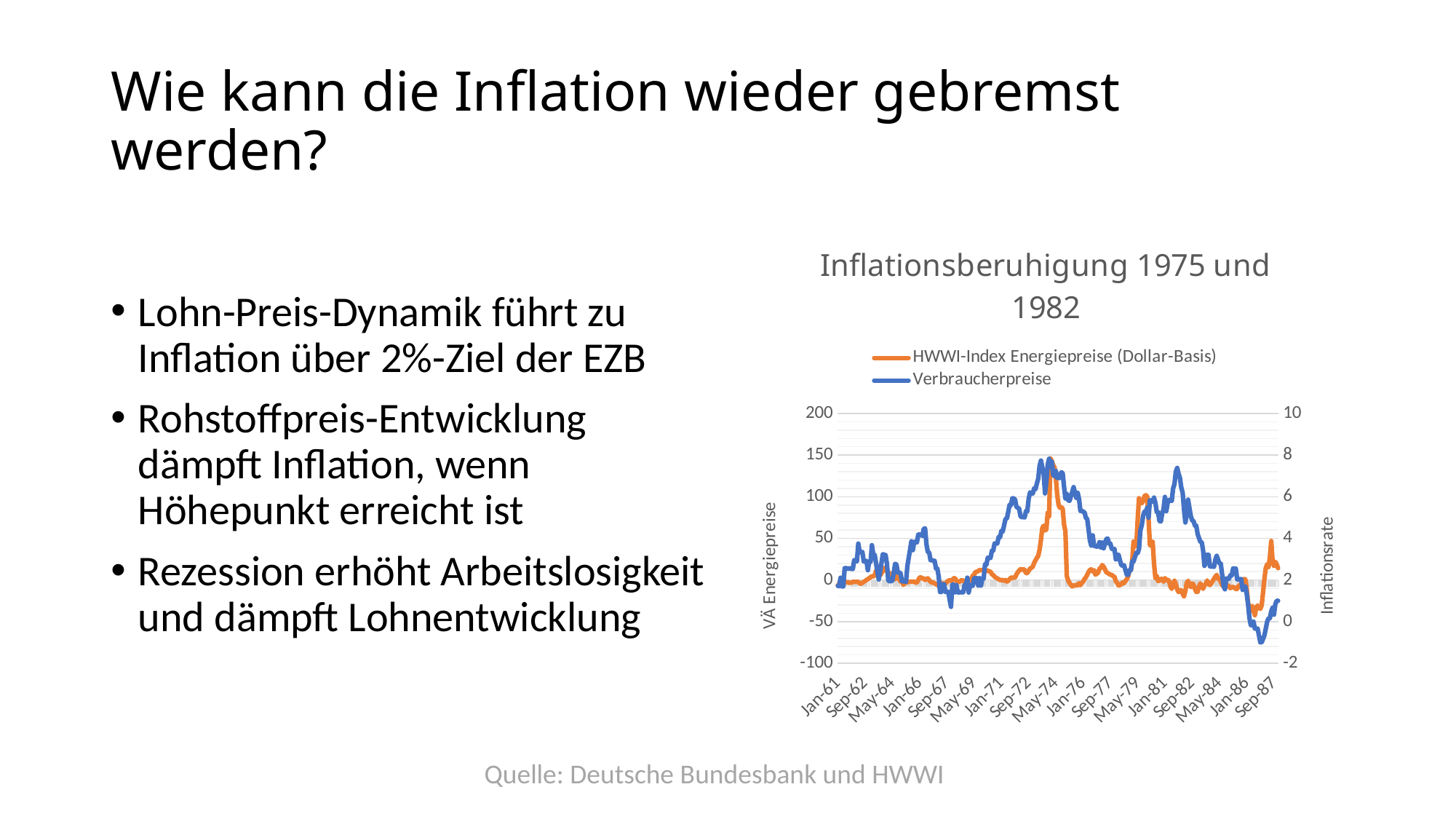
What kind of chart is shown on the slide? Line chart Is the value of the Verbraucherpreise line at its low point around Jan-86 greater or less than 0 on the right axis? less Which series is drawn in orange in the chart? HWWI-Index Energiepreise (Dollar-Basis) Does the Verbraucherpreise line rise or fall between Sep-82 and Jan-86? fall Is the peak value of the HWWI-Index Energiepreise (Dollar-Basis) line around May-74 greater or less than 100 on the left axis? greater Near which x-axis label does the HWWI-Index Energiepreise (Dollar-Basis) line reach its highest point? May-74 Is the value of the HWWI-Index Energiepreise (Dollar-Basis) line at Jan-61 greater or less than 50 on the left axis? less What is the title of the chart? Inflationsberuhigung 1975 und 1982 Does the Verbraucherpreise line rise or fall between May-74 and Jan-76? fall How many date labels are shown on the x axis of the chart? 17 How many series does the chart legend list? 2